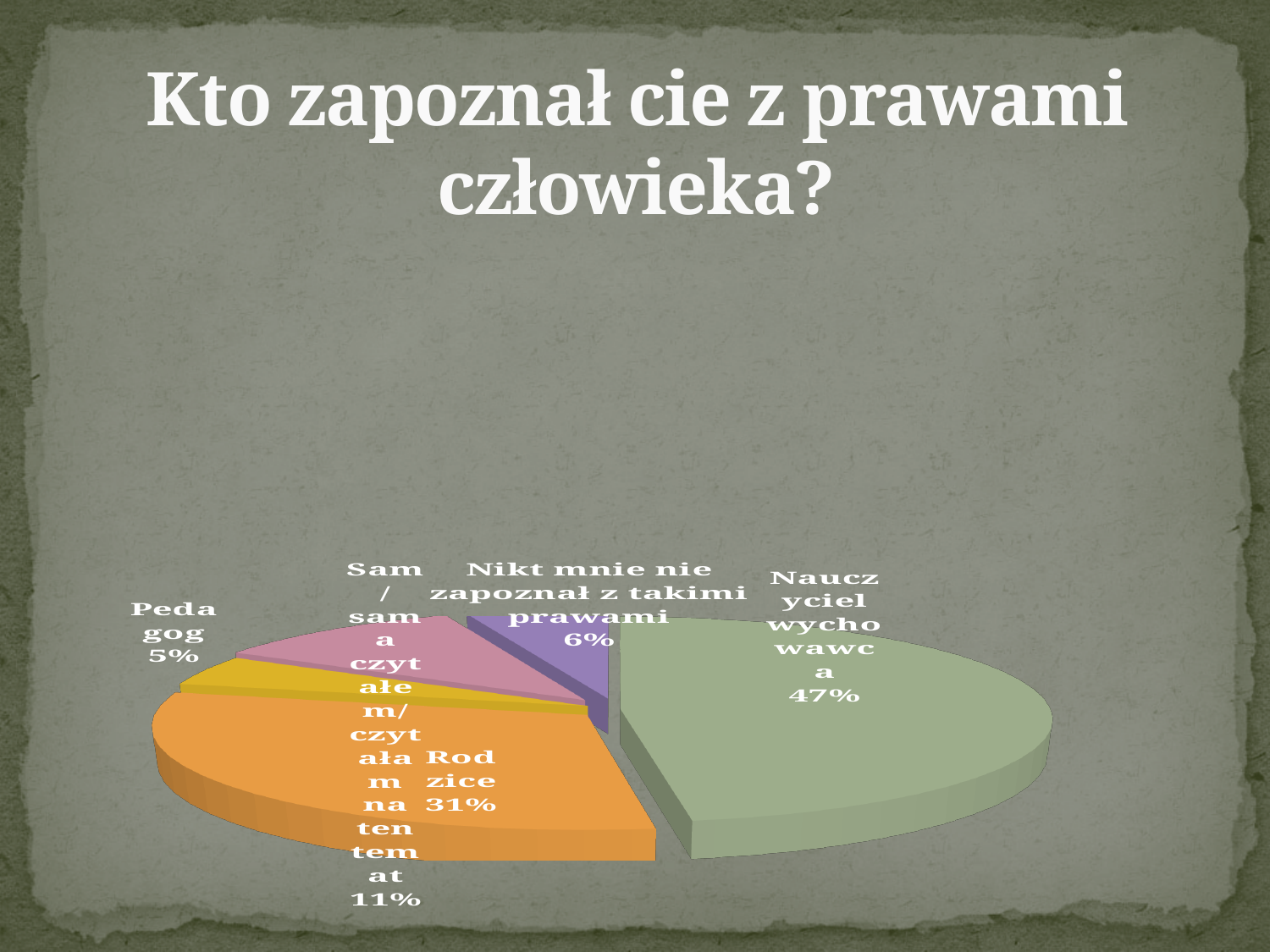
Which is larger, the "Rodzice" slice or the "Sam/sama czytałem/czytałam na ten temat" slice? Rodzice How many slices does the pie chart have? 5 What percentage of the pie is labelled "Nikt mnie nie zapoznał z takimi prawami"? 6% What percentage of the pie is labelled "Rodzice"? 31% What is the difference in percentage points between the "Nauczyciel wychowawca" slice and the "Rodzice" slice? 16 What percentage of the pie is labelled "Pedagog"? 5% What percentage of the pie is labelled "Sam/sama czytałem/czytałam na ten temat"? 11% What percentage of the pie is labelled "Nauczyciel wychowawca"? 47% What kind of chart is shown on the slide? pie chart Which slice of the pie is the largest? Nauczyciel wychowawca What is the title of the slide containing the pie chart? Kto zapoznał cie z prawami człowieka? Which slice of the pie is the smallest? Pedagog